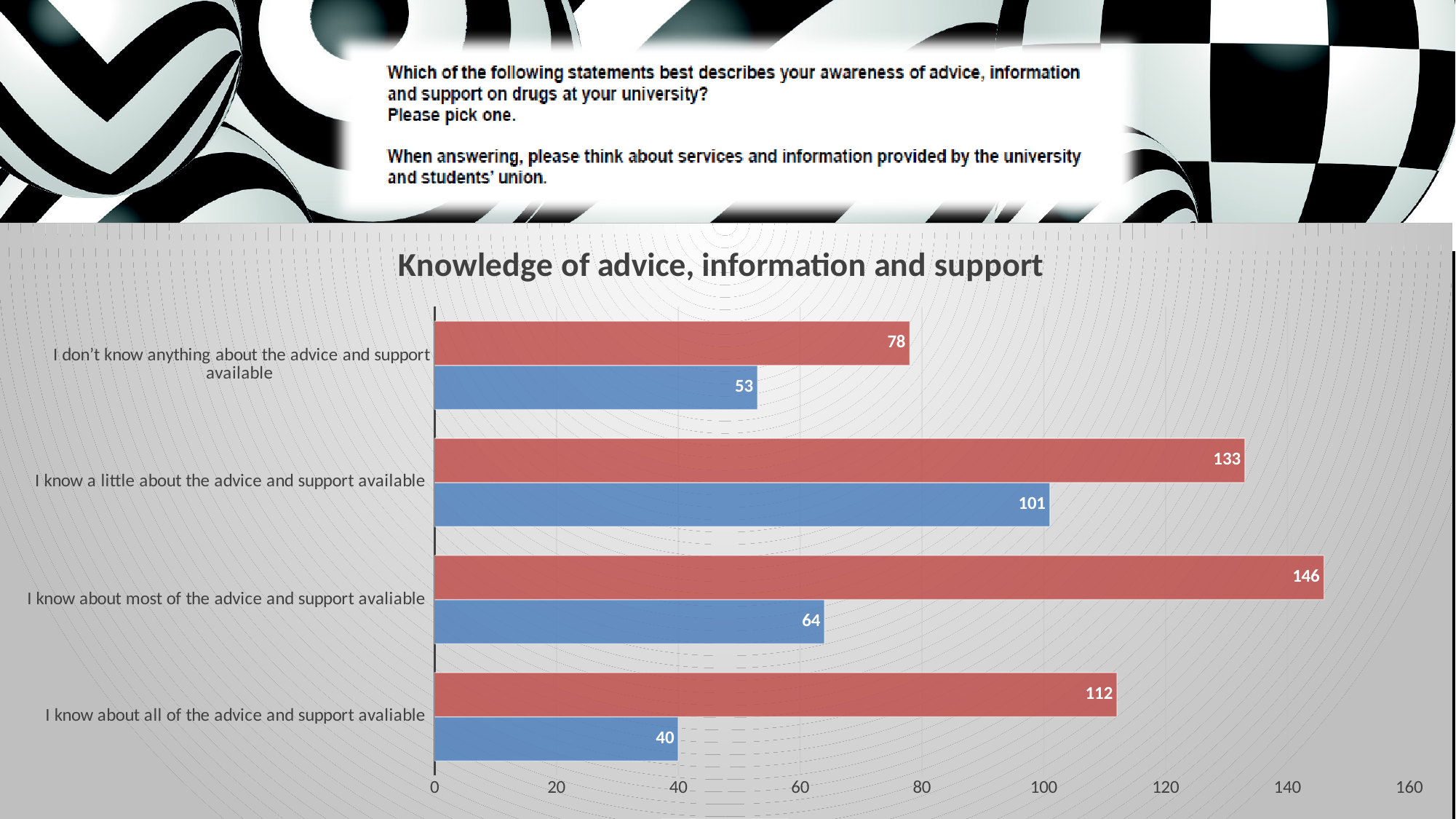
How many categories are shown on the chart? 4 Which is larger: the blue bar for "I know a little about the advice and support available" or the blue bar for "I know about most of the advice and support avaliable"? I know a little about the advice and support available What is the difference between the red bar values for "I know a little about the advice and support available" and "I know about all of the advice and support avaliable"? 21 What is the value of the blue bar for "I know a little about the advice and support available"? 101 What type of chart is shown on the slide? Bar chart What is the value of the red bar for "I don't know anything about the advice and support available"? 78 What is the value of the red bar for "I know about most of the advice and support avaliable"? 146 Which category has the lowest blue bar value? I know about all of the advice and support avaliable What is the value of the blue bar for "I know about all of the advice and support avaliable"? 40 Is the red bar value for "I know about all of the advice and support avaliable" greater or less than 100? greater Which category has the highest red bar value? I know about most of the advice and support avaliable What is the difference between the red and blue bar values for "I know about most of the advice and support avaliable"? 82